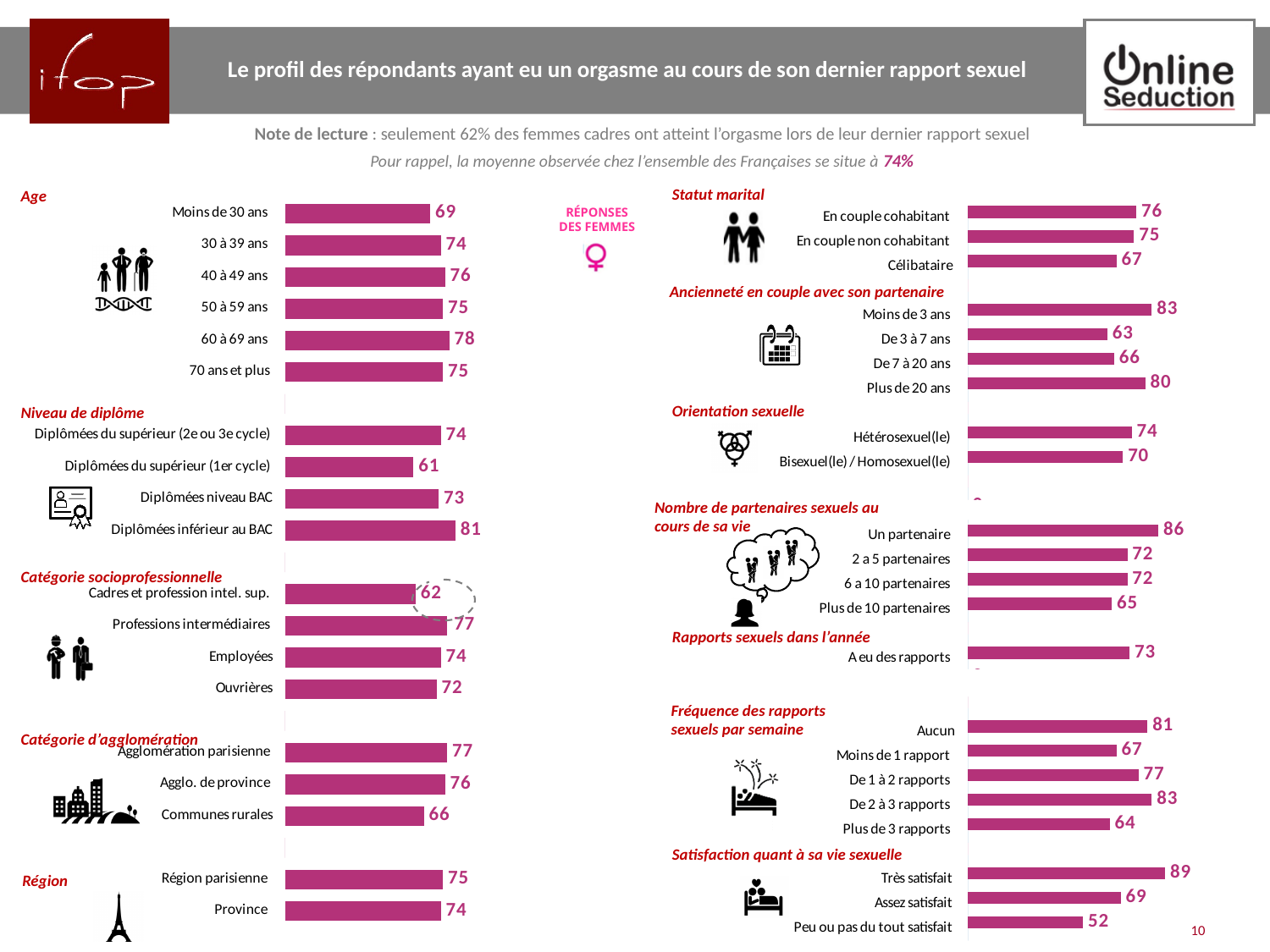
In the 'Satisfaction quant à sa vie sexuelle' chart, what is the difference between 'Très satisfait' and 'Assez satisfait'? 20 In the 'Ancienneté en couple avec son partenaire' chart, what is the value for 'Moins de 3 ans'? 83 In the 'Nombre de partenaires sexuels au cours de sa vie' chart, which category has the highest value? Un partenaire In the 'Catégorie socioprofessionnelle' chart, what is the value for 'Cadres et profession intel. sup.'? 62 In the 'Age' chart, which age group has the lowest value? Moins de 30 ans In the 'Catégorie d'agglomération' chart, which is larger: 'Agglomération parisienne' or 'Communes rurales'? Agglomération parisienne In the 'Niveau de diplôme' chart, which category has the highest value? Diplômées inférieur au BAC In the 'Age' chart, what is the value for '60 à 69 ans'? 78 What type of chart is used in the 'Statut marital' section? Bar chart In the 'Satisfaction quant à sa vie sexuelle' chart, what is the value for 'Peu ou pas du tout satisfait'? 52 In the 'Fréquence des rapports sexuels par semaine' chart, how many categories are shown? 5 In the 'Niveau de diplôme' chart, what is the difference between 'Diplômées inférieur au BAC' and 'Diplômées du supérieur (1er cycle)'? 20